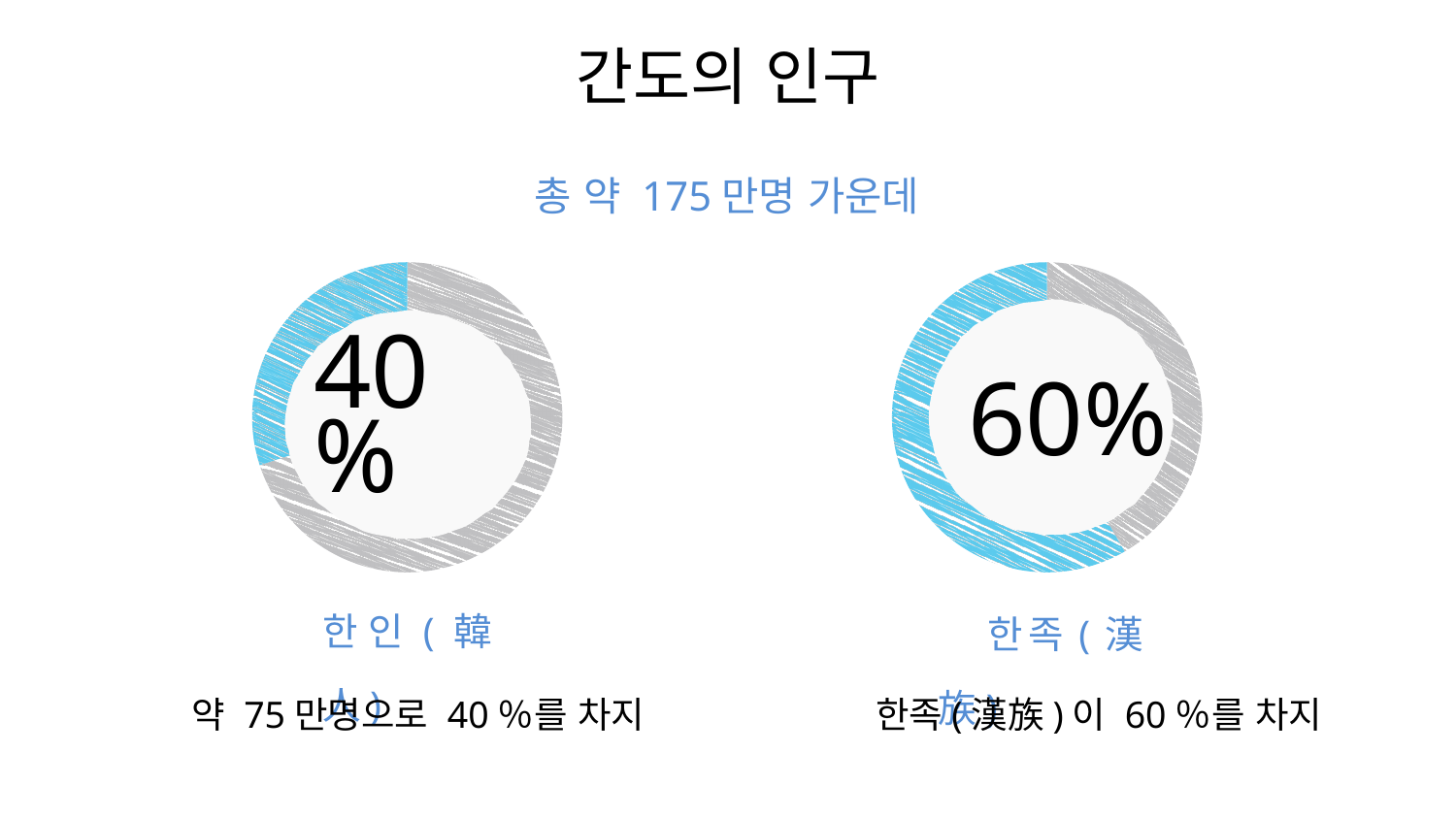
What percentage is shown in the centre of the right donut chart (한족)? 60% What is the difference in percentage points between the 한족 share (60%) and the 한인 share (40%)? 20 How many donut charts are shown on the slide? 2 Is the value shown in the right donut chart (한족) greater or less than 50%? greater Is the value shown in the left donut chart (한인) greater or less than 50%? less What percentage is shown in the centre of the left donut chart (한인)? 40% Which group has the larger share of the population, 한인 or 한족? 한족 What colour is used for the filled (highlighted) portion of each donut chart? Blue What is the total population stated above the charts? 약 175만명 What is the title of the slide? 간도의 인구 What kind of chart is used on this slide to show the population shares? Donut (pie) chart According to the text under the left chart, how many people does the 40% 한인 share correspond to? 약 75만명